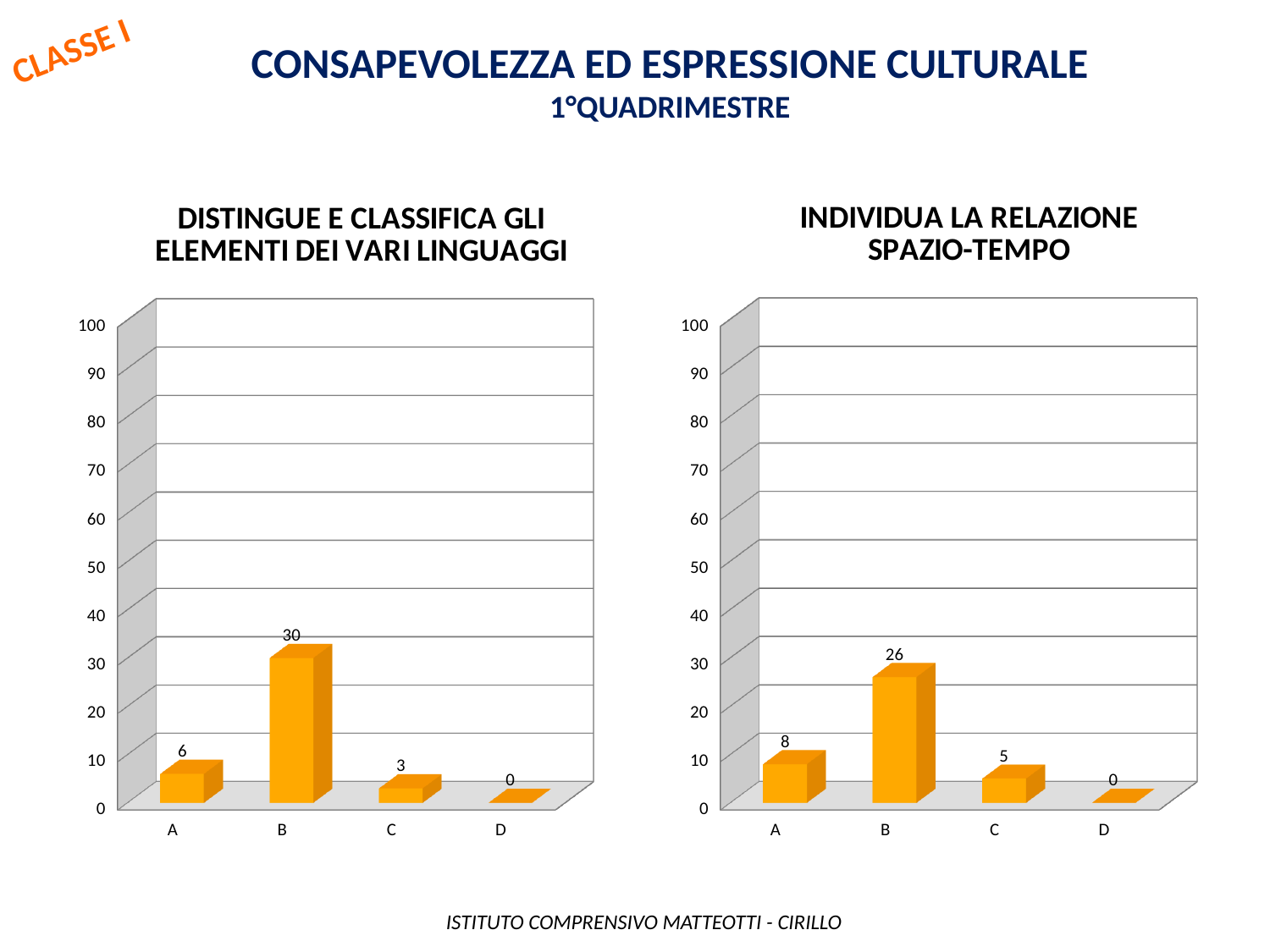
In the left chart, what is the value for category D? 0 In the right chart, what is the difference between the values for B and C? 21 In the left chart, which category has the highest value? B In the left chart, is the value for B greater or less than 40? less In the left chart, what is the difference between the values for B and A? 24 In the chart titled "DISTINGUE E CLASSIFICA GLI ELEMENTI DEI VARI LINGUAGGI", what is the value for category B? 30 What kind of chart is the chart titled "DISTINGUE E CLASSIFICA GLI ELEMENTI DEI VARI LINGUAGGI"? Bar chart In the chart titled "INDIVIDUA LA RELAZIONE SPAZIO-TEMPO", what is the value for category A? 8 In the right chart, which is larger, the value for A or the value for C? A How many categories are shown in the chart titled "INDIVIDUA LA RELAZIONE SPAZIO-TEMPO"? 4 What is the maximum value shown on the vertical axis of the right chart? 100 In the right chart, which category has the lowest value? D